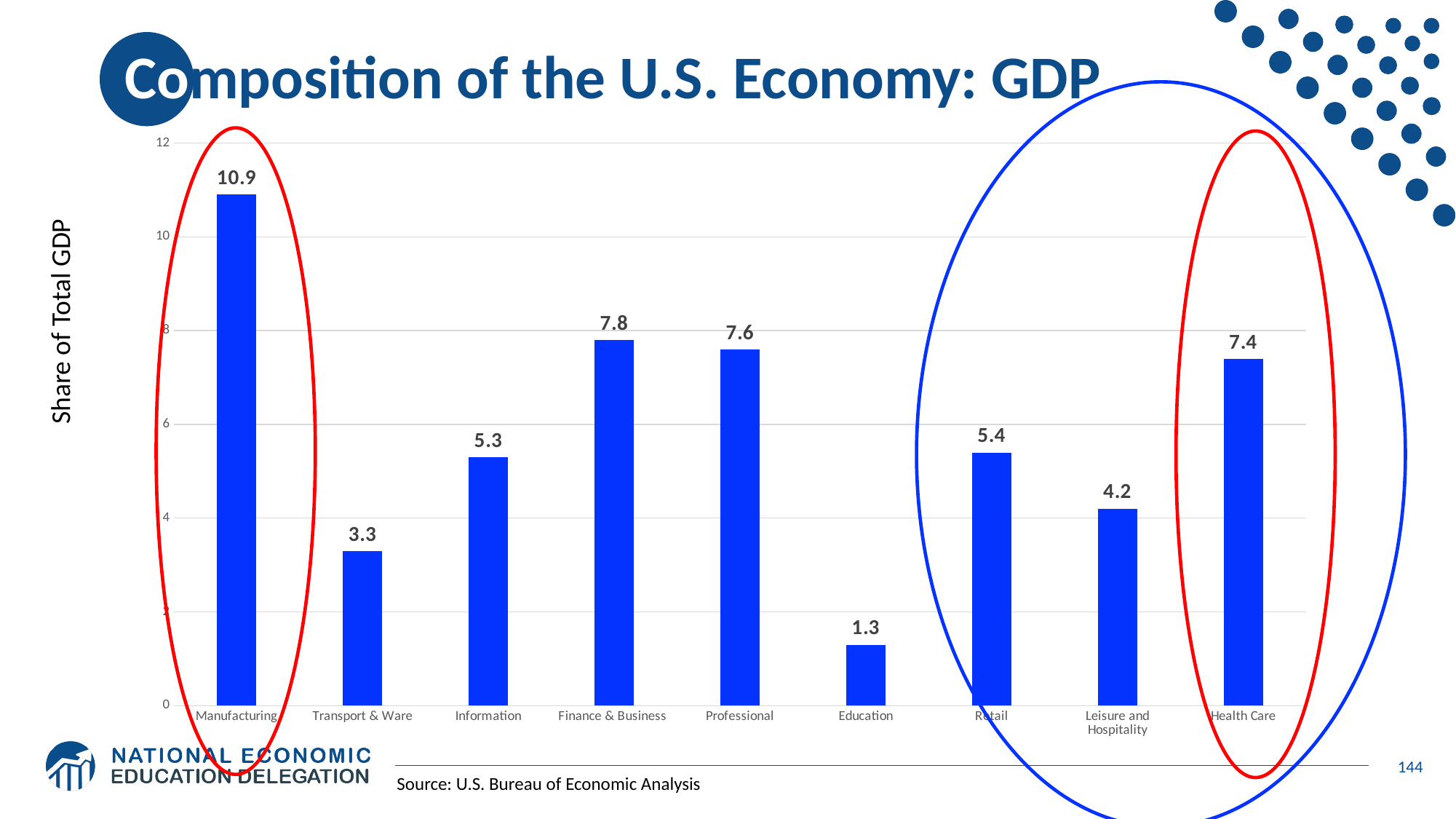
Which category has the lowest share of total GDP? Education What is the difference between the values for Retail and Education? 4.1 What is the difference between the values for Manufacturing and Health Care? 3.5 What is the share of total GDP for Health Care? 7.4 Is the value for Finance & Business greater or less than 6? greater Which category has the highest share of total GDP? Manufacturing What kind of chart is shown on the slide? Bar chart What is the label of the vertical axis? Share of Total GDP How many categories are shown on the x axis? 9 What is the value shown for Leisure and Hospitality? 4.2 Which has a larger share of total GDP, Information or Transport & Ware? Information What is the share of total GDP for Manufacturing? 10.9